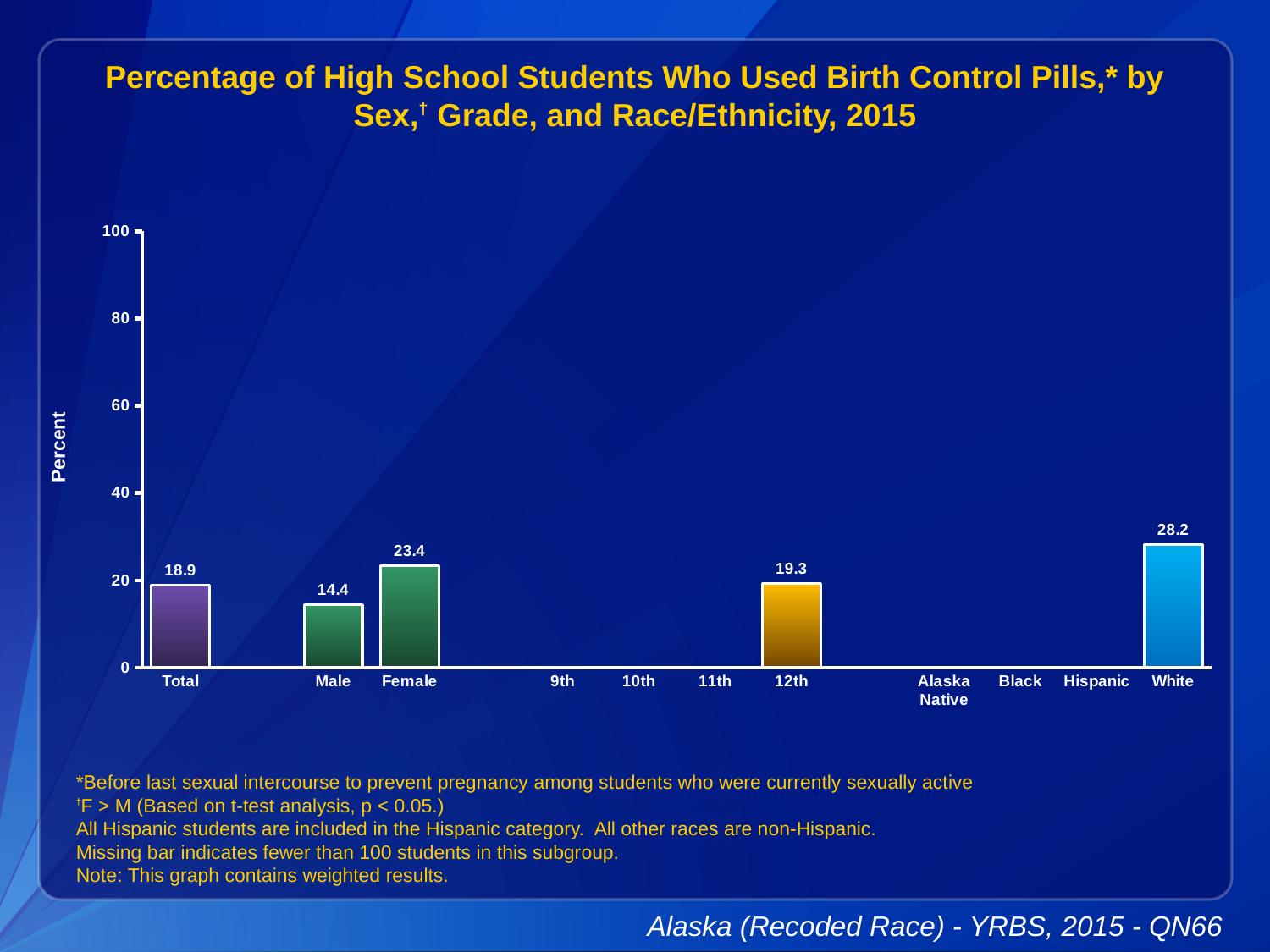
Is the value for White greater or less than 20? greater What is the difference between the Female and Male values? 9.0 What kind of chart is shown? bar chart How many categories have a bar plotted? 5 What is the value for White? 28.2 What is the value for Female? 23.4 Which is larger, the value for Total or the value for 12th grade? 12th What is the value for Total? 18.9 What is the value for 12th grade? 19.3 What is the label on the y axis? Percent Which category has the highest value? White Which category has the lowest plotted value? Male